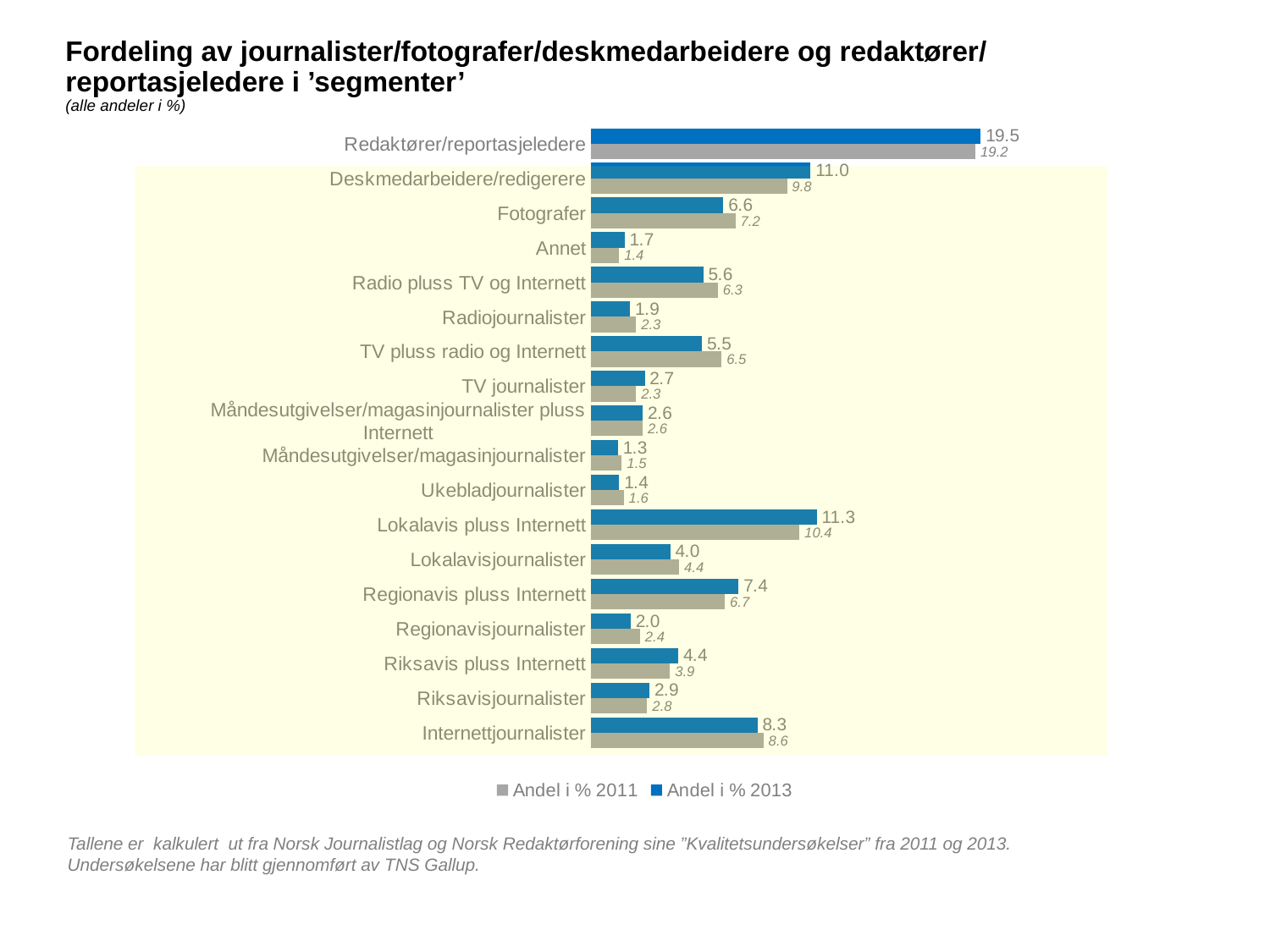
What is the value for Redaktører/reportasjeledere in the Andel i % 2013 series? 19.5 What is the value for Internettjournalister in the Andel i % 2013 series? 8.3 Which colour represents the Andel i % 2013 series? Blue What is the difference between the Andel i % 2013 and Andel i % 2011 values for Deskmedarbeidere/redigerere? 1.2 What kind of chart is shown on the slide? Bar chart For Fotografer, which series has the larger value: Andel i % 2011 or Andel i % 2013? Andel i % 2011 How many series does the legend list? 2 What is the value for Deskmedarbeidere/redigerere in the Andel i % 2011 series? 9.8 Which category has the highest value in the Andel i % 2013 series? Redaktører/reportasjeledere What is the value for Lokalavis pluss Internett in the Andel i % 2011 series? 10.4 How many categories are shown in the chart? 18 Which category has the lowest value in the Andel i % 2013 series? Måndesutgivelser/magasinjournalister